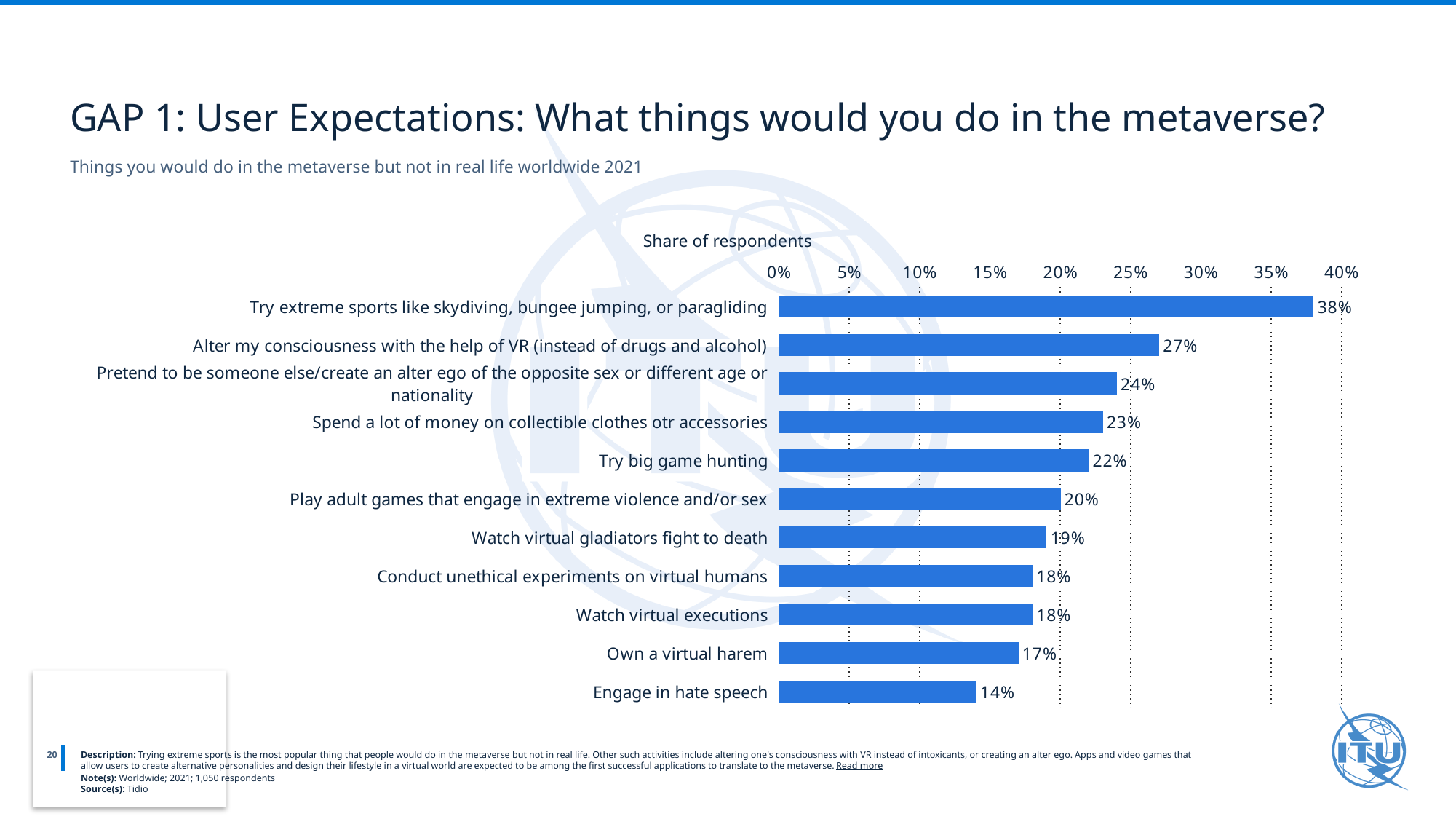
Which has a larger share of respondents: 'Try big game hunting' or 'Watch virtual gladiators fight to death'? Try big game hunting Is the value for 'Spend a lot of money on collectible clothes otr accessories' greater or less than 20%? greater How many activities (categories) are shown in the chart? 11 Which activity has the lowest share of respondents? Engage in hate speech What is the axis title shown above the chart? Share of respondents What share of respondents would try extreme sports like skydiving, bungee jumping, or paragliding in the metaverse? 38% What is the value for 'Own a virtual harem'? 17% Which activity has the highest share of respondents? Try extreme sports like skydiving, bungee jumping, or paragliding What type of chart is shown on the slide? Bar chart What share of respondents would alter their consciousness with the help of VR (instead of drugs and alcohol)? 27% What is the difference between the share for 'Try extreme sports like skydiving, bungee jumping, or paragliding' and 'Alter my consciousness with the help of VR (instead of drugs and alcohol)'? 11% What is the value for 'Engage in hate speech'? 14%